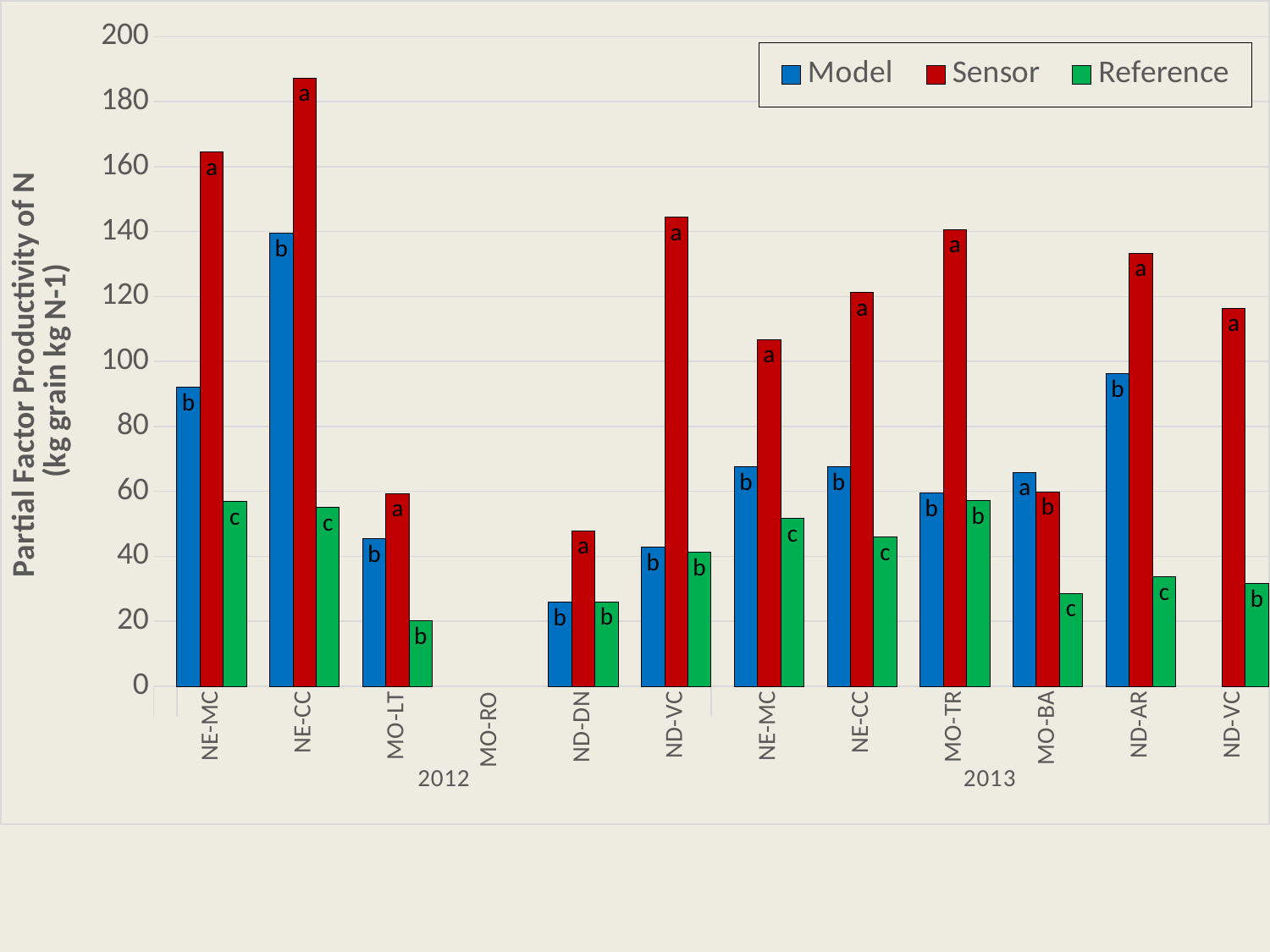
Is the Sensor value for NE-CC in 2012 greater or less than 180? greater How many site categories are labelled on the x axis? 12 Which category has the highest Model bar? NE-CC (2012) Which is larger for NE-MC in 2013, the Model value or the Reference value? Model What is the y-axis title of the chart? Partial Factor Productivity of N (kg grain kg N-1) Is the Sensor value for ND-VC in 2013 greater or less than 100? greater What kind of chart is shown on the slide? bar chart Which category has the lowest Reference bar? MO-LT (2012) Is the Model value for ND-AR in 2013 greater or less than 100? less What are the series names listed in the legend? Model, Sensor, Reference How many series does the legend list? 3 Which category has the highest Sensor bar? NE-CC (2012)